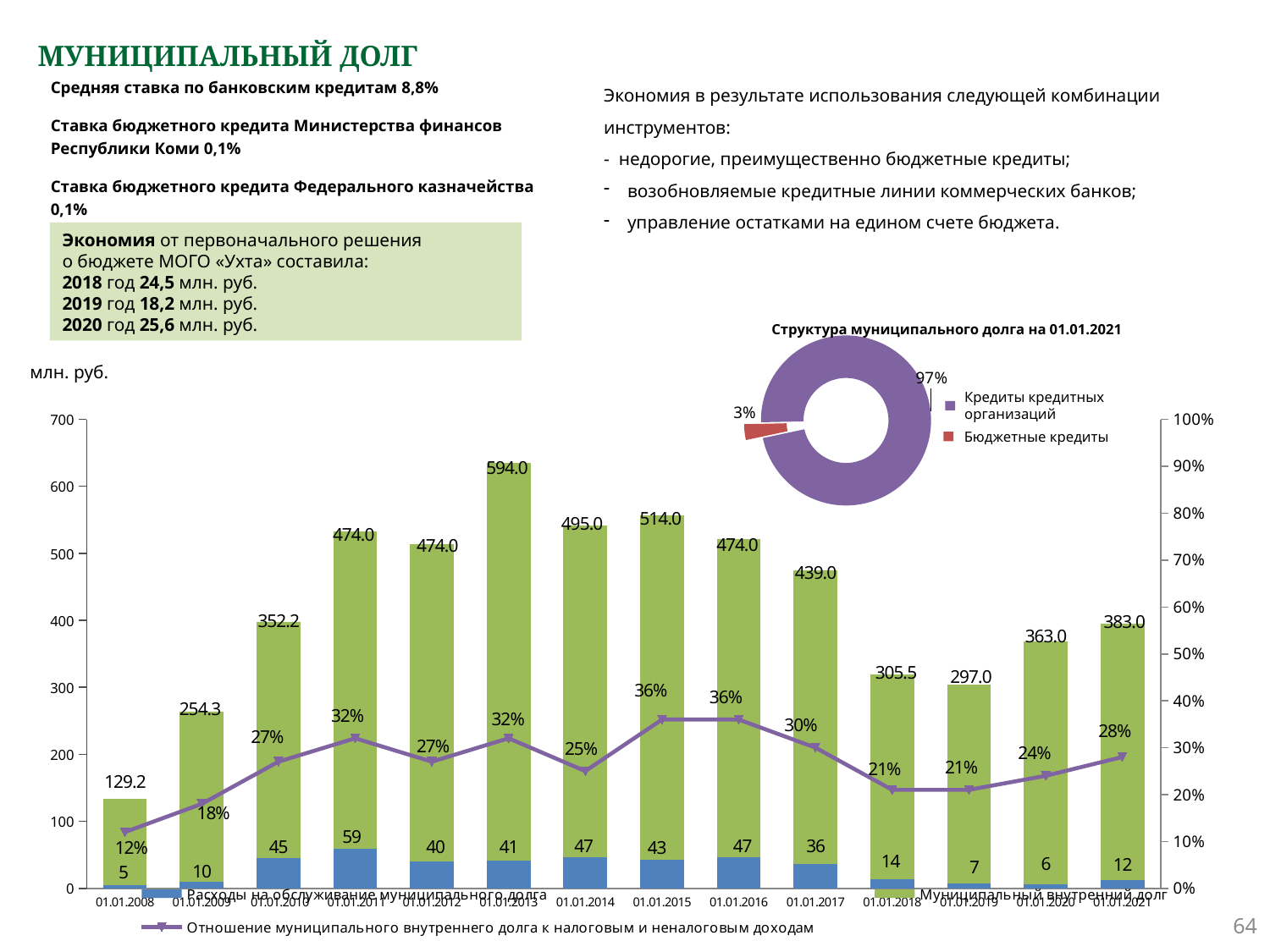
On the donut chart 'Структура муниципального долга на 01.01.2021', what share is 'Бюджетные кредиты'? 3% On the main bar chart, what is the value of the municipal internal debt (Муниципальный внутренний долг) on 01.01.2013? 594.0 On the main bar chart, what is the ratio of municipal internal debt to tax and non-tax revenues on 01.01.2021? 28% How many series does the legend of the main bar chart list? 3 On the donut chart 'Структура муниципального долга на 01.01.2021', which category has the largest share? Кредиты кредитных организаций On the main bar chart, what is the difference between the municipal internal debt on 01.01.2013 and on 01.01.2014? 99.0 On the main bar chart, on which date is the municipal internal debt highest? 01.01.2013 On the main bar chart, on which date are the expenses on servicing municipal debt lowest? 01.01.2008 On the main bar chart, which is larger: the municipal internal debt on 01.01.2020 or on 01.01.2021? 01.01.2021 On the main bar chart, what are the expenses on servicing municipal debt (Расходы на обслуживание муниципального долга) on 01.01.2011? 59 On the main bar chart, what is the value of the municipal internal debt on 01.01.2008? 129.2 On the main bar chart, how many dates are shown on the x axis? 14